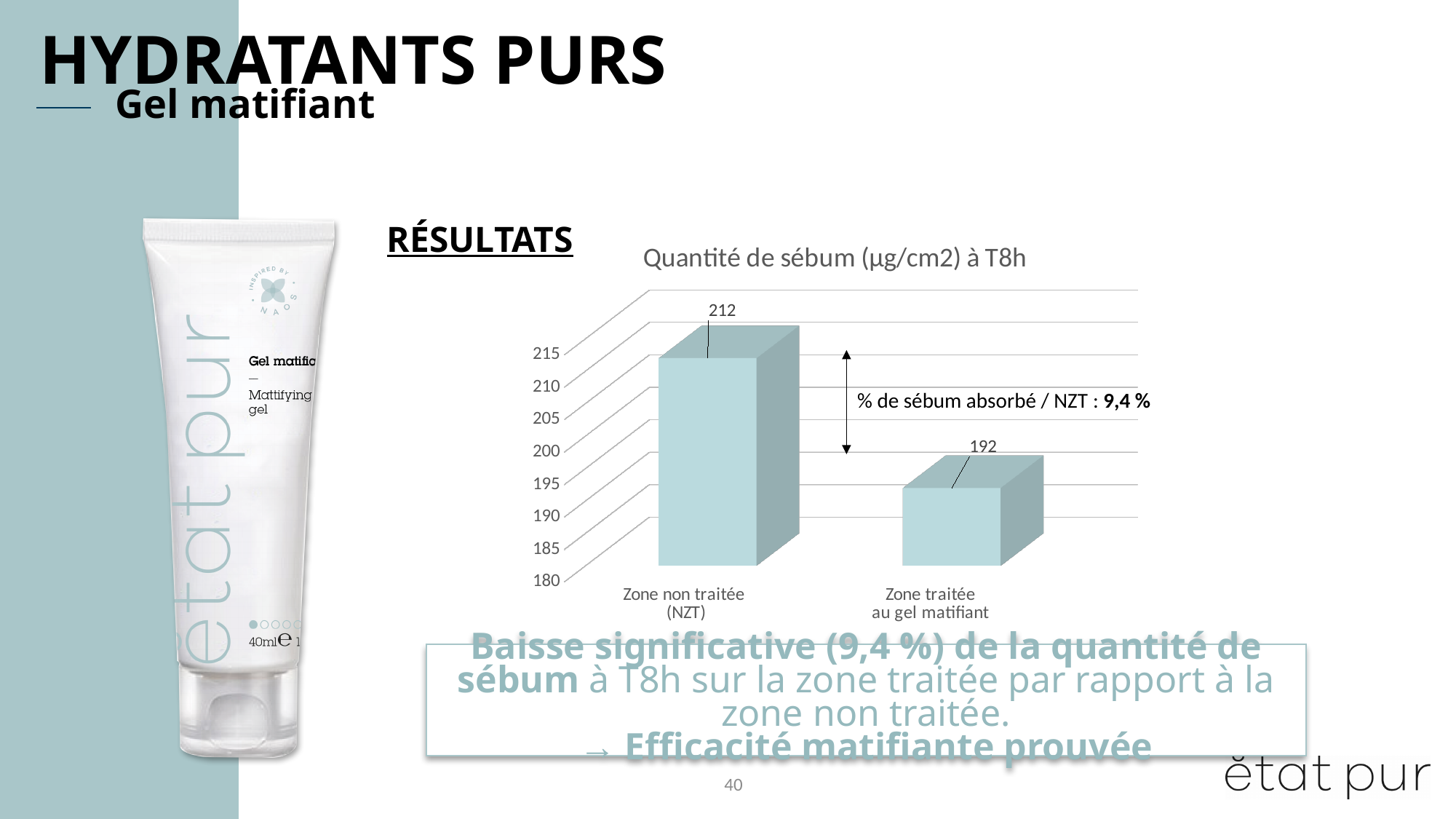
What is the value for Zone non traitée (NZT)? 212 What is the title of the chart? Quantité de sébum (µg/cm2) à T8h What is the value for Zone traitée au gel matifiant? 192 Is the value for Zone non traitée (NZT) greater or less than 205? greater Is the value for Zone traitée au gel matifiant greater or less than 200? less Which category has the lowest sebum quantity? Zone traitée au gel matifiant What percentage of sebum absorbed relative to NZT is annotated on the chart? 9,4 % Which is larger, the value for Zone non traitée (NZT) or for Zone traitée au gel matifiant? Zone non traitée (NZT) What kind of chart is shown on the slide? Bar chart How many categories are shown in the chart? 2 Which category has the highest sebum quantity? Zone non traitée (NZT) What is the difference between the values for Zone non traitée (NZT) and Zone traitée au gel matifiant? 20